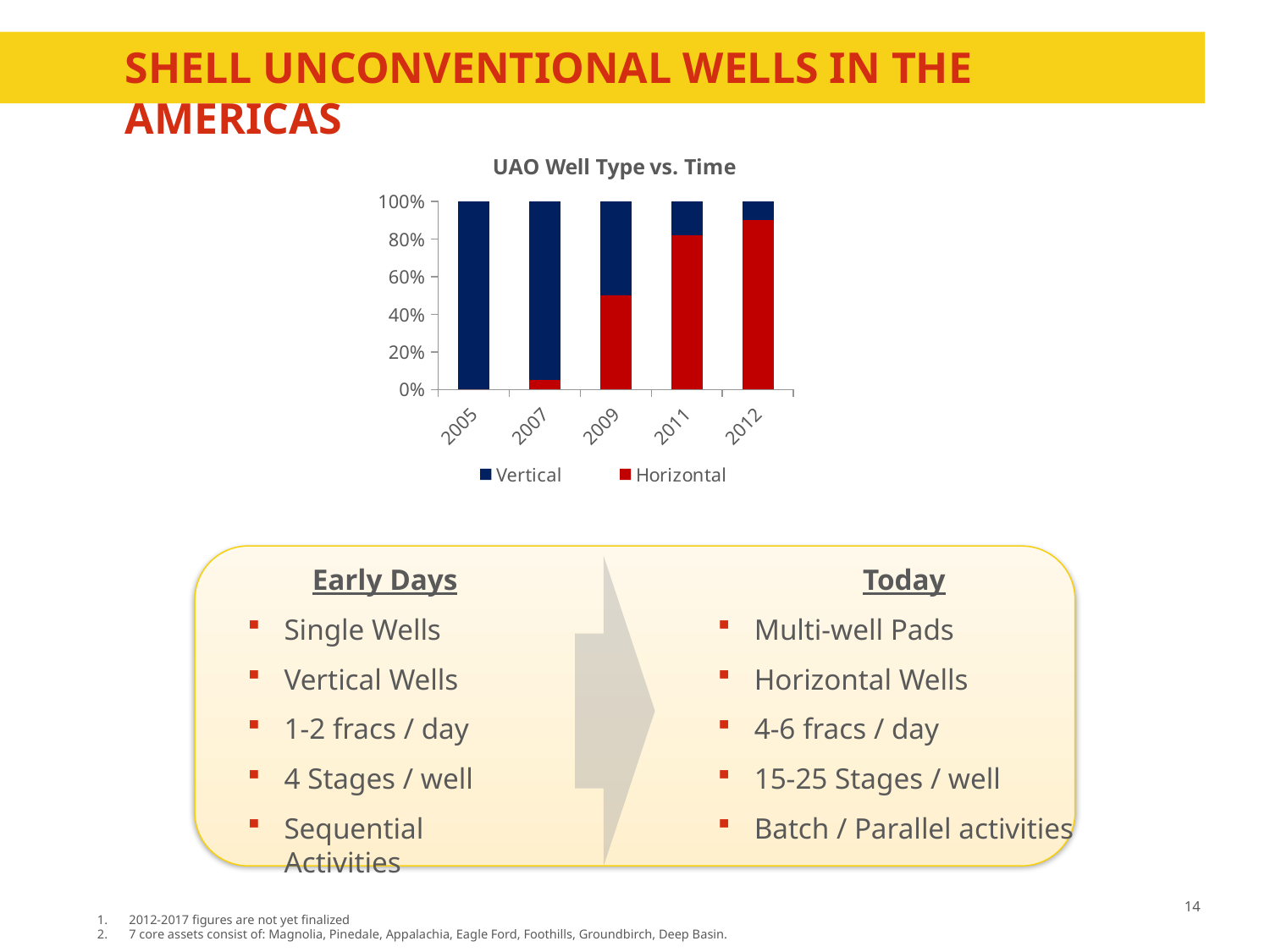
How many years are shown on the x axis of the chart? 5 Does the Horizontal share rise or fall from 2005 to 2012? Rises In which year is the Horizontal share the lowest? 2005 In which year is the Horizontal share the highest? 2012 What kind of chart is shown on the slide? Stacked bar chart How many series does the chart's legend list? 2 What is the value of the Vertical series for 2005? 100% Is the Horizontal value for 2007 greater or less than 20%? less Which year has a larger Horizontal share, 2009 or 2011? 2011 Is the Horizontal value for 2012 greater or less than 80%? greater What is the title of the chart on the slide? UAO Well Type vs. Time What is the total height of the stacked bar for 2012? 100%